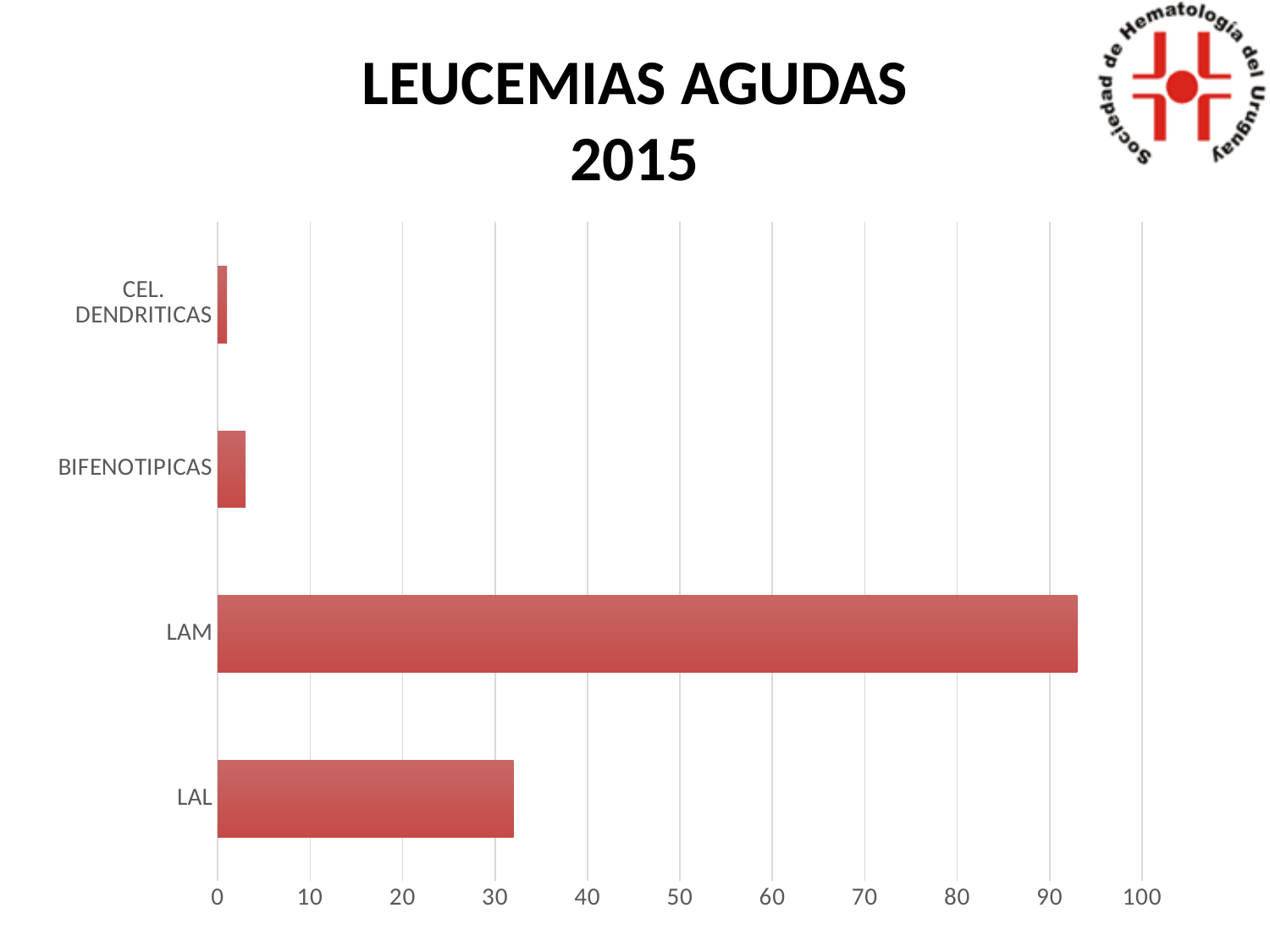
Which is larger, the value for LAM or the value for LAL? LAM Is the value for LAL greater or less than 30? greater What is the title of the slide containing the chart? LEUCEMIAS AGUDAS 2015 Which is larger, the value for BIFENOTIPICAS or the value for CEL. DENDRITICAS? BIFENOTIPICAS Is the value for LAM greater or less than 90? greater Is the value for BIFENOTIPICAS greater or less than 10? less Which category has the lowest value? CEL. DENDRITICAS What kind of chart is shown on the slide? bar chart What is the maximum value shown on the horizontal axis? 100 How many categories are plotted in the chart? 4 Which category has the highest value? LAM